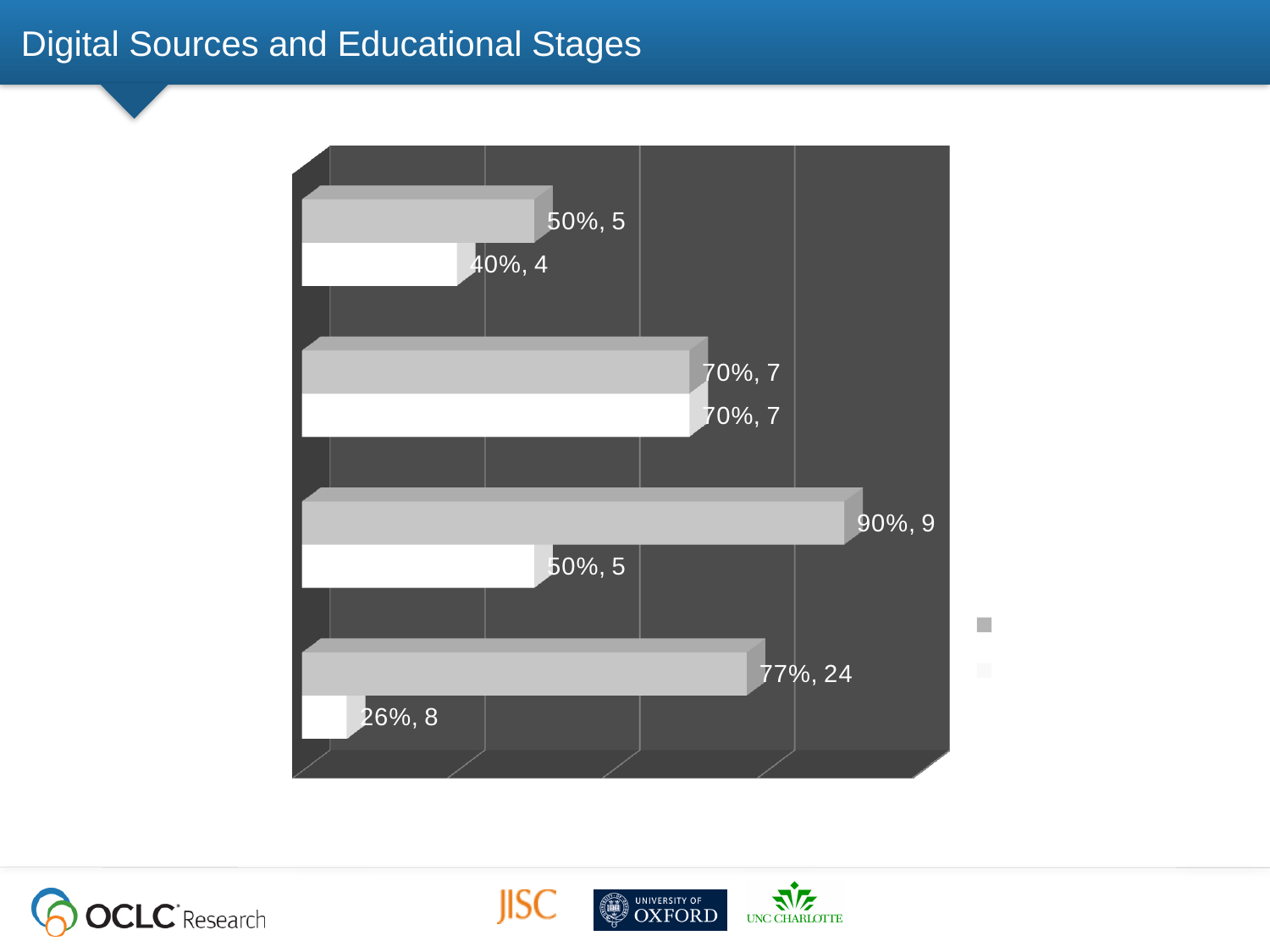
Which group of bars contains the longest grey bar? the third group from the top (90%, 9) In the bottom group, which bar shows the larger percentage, the grey bar or the white bar? the grey bar What is the title of the slide containing the chart? Digital Sources and Educational Stages What kind of chart is shown on the slide? bar chart What is the data label on the white bar in the top group? 40%, 4 What is the data label on the white bar in the bottom group? 26%, 8 How many groups of bars (categories) does the chart show? 4 What is the data label on the grey bar in the top group? 50%, 5 What is the data label on the grey bar in the bottom group? 77%, 24 In the third group from the top, what is the difference in percentage between the grey bar and the white bar? 40 percentage points In the second group from the top, what percentage do both the grey and white bars show? 70% How many series does the legend list? 2